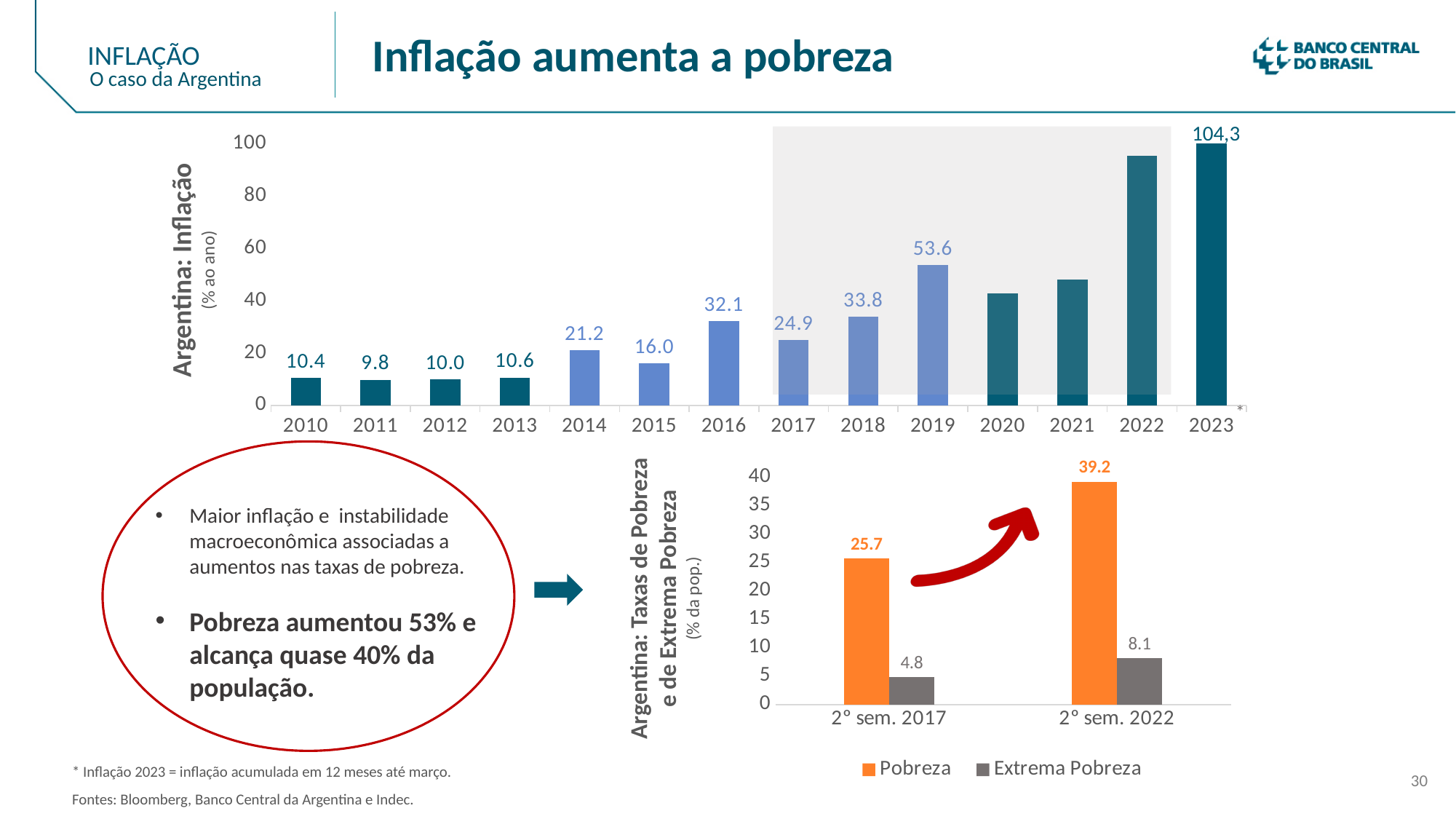
In the top chart (Argentina: Inflação), is the value for 2020 greater or less than 60? less In the bottom chart (Argentina: Taxas de Pobreza e de Extrema Pobreza), what is the Pobreza value for 2° sem. 2022? 39.2 In the top chart (Argentina: Inflação), is the value for 2022 greater or less than 80? greater In the top chart (Argentina: Inflação), how many years are shown on the x axis? 14 In the top chart (Argentina: Inflação), what is the inflation value for 2023? 104,3 In the top chart (Argentina: Inflação), which year has the highest inflation value? 2023 In the top chart (Argentina: Inflação), what is the inflation value for 2019? 53.6 In the bottom chart (Argentina: Taxas de Pobreza e de Extrema Pobreza), how many series does the legend list? 2 In the top chart (Argentina: Inflação), what is the difference between the 2016 and 2017 values? 7.2 In the top chart (Argentina: Inflação), which year has the lowest inflation value? 2011 In the bottom chart (Argentina: Taxas de Pobreza e de Extrema Pobreza), what is the difference between the Extrema Pobreza values for 2° sem. 2022 and 2° sem. 2017? 3.3 What kind of chart is the bottom chart (Argentina: Taxas de Pobreza e de Extrema Pobreza)? Bar chart